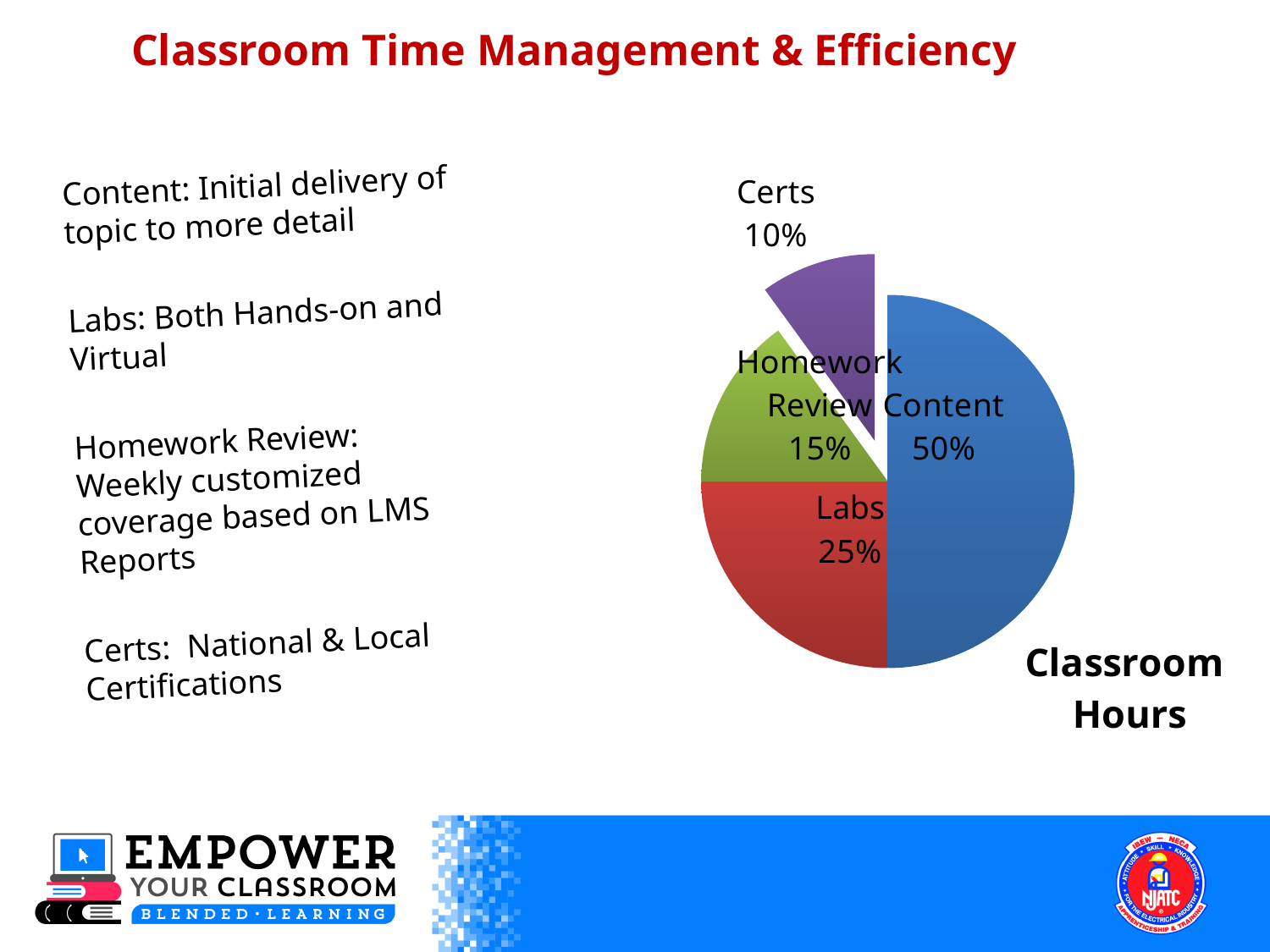
Which category has the largest share of Classroom Hours? Content What is the difference in percentage points between Labs and Homework Review? 10 What share of Classroom Hours is Content? 50% What is the difference in percentage points between Content and Labs? 25 How many slices does the pie chart have? 4 What share of Classroom Hours is Certs? 10% What share of Classroom Hours is Labs? 25% What kind of chart is shown on the slide? pie chart What is the title of the pie chart? Classroom Hours Which is larger, the share for Homework Review or the share for Certs? Homework Review Which category has the smallest share of Classroom Hours? Certs